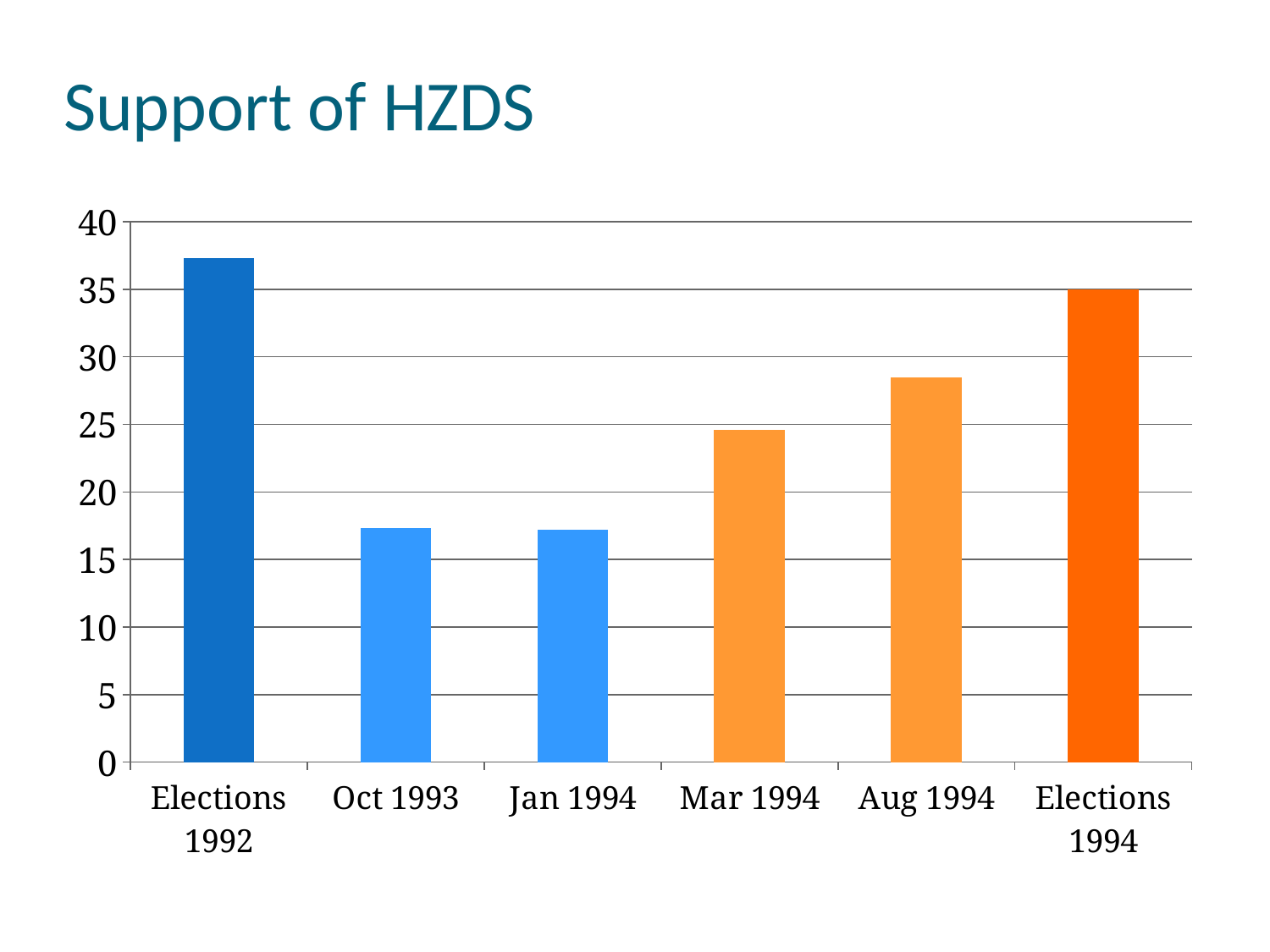
What type of chart is shown on the slide? bar chart What is the title of the chart? Support of HZDS Which is larger, the value for Mar 1994 or the value for Aug 1994? Aug 1994 Is the value for Oct 1993 greater or less than 15? greater Which category has the highest value? Elections 1992 Is the value for Jan 1994 greater or less than 20? less How many categories are shown on the x axis? 6 Do the values rise or fall from Jan 1994 to Elections 1994? rise Which is larger, the value for Elections 1992 or the value for Elections 1994? Elections 1992 Is the value for Elections 1992 greater or less than 35? greater